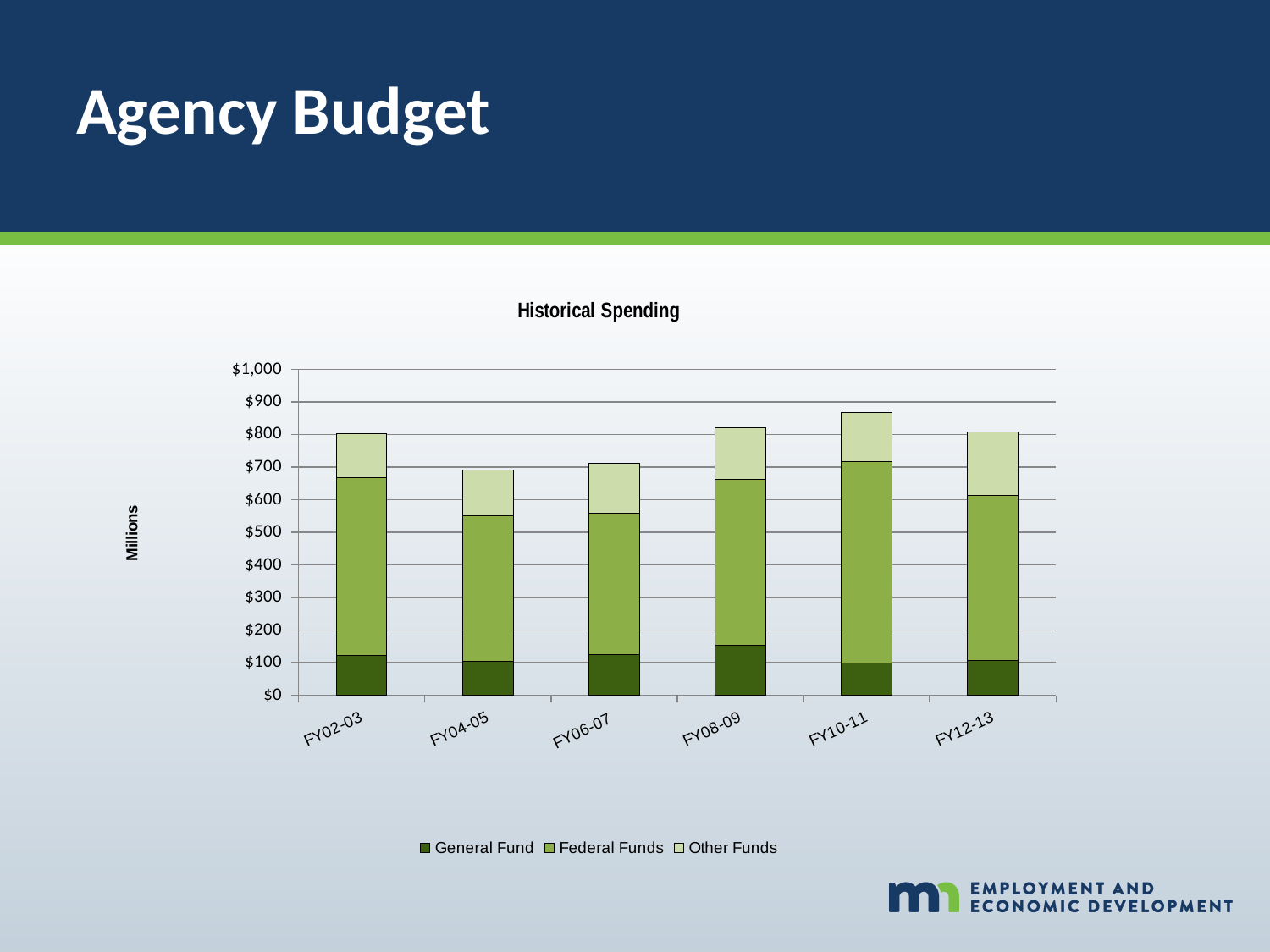
How many series does the legend list? 3 What is the label on the vertical axis? Millions Is the total spending for FY04-05 greater or less than $800? less What is the title of the chart? Historical Spending Which fiscal year period has the highest total spending? FY10-11 Is the total spending for FY02-03 greater or less than $700? greater What type of chart is shown on the slide? Stacked bar chart Is the total spending for FY10-11 greater or less than $800? greater Which has the larger Federal Funds segment, FY10-11 or FY12-13? FY10-11 Which has the larger total spending, FY10-11 or FY04-05? FY10-11 How many fiscal year periods are shown on the x axis? 6